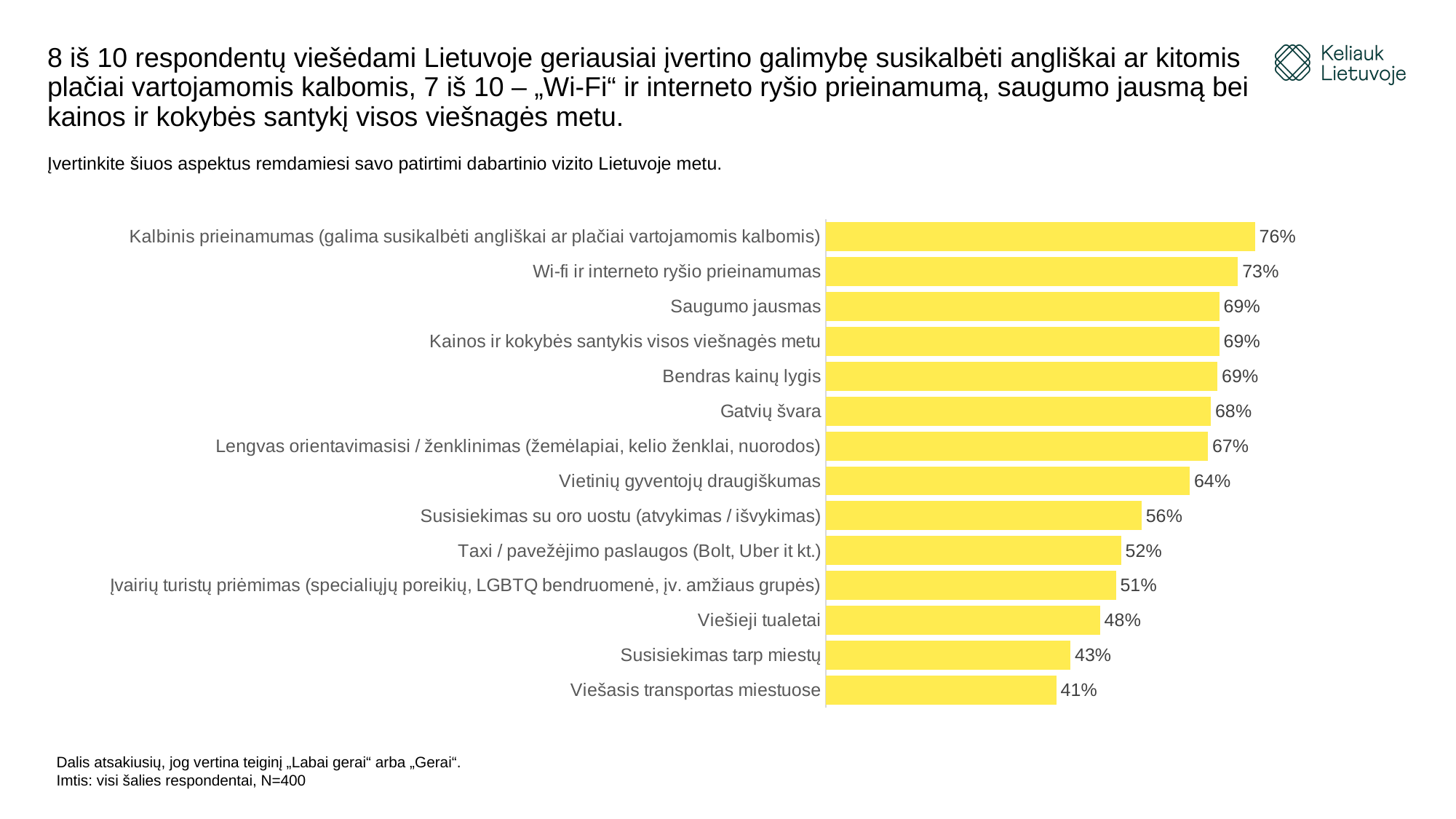
What is the value for "Viešieji tualetai"? 48% What is the value for "Gatvių švara"? 68% What kind of chart is shown on the slide? Bar chart What is the difference between the values for "Kalbinis prieinamumas" and "Viešasis transportas miestuose"? 35% Which category has the lowest value? Viešasis transportas miestuose Which category has the highest value? Kalbinis prieinamumas (galima susikalbėti angliškai ar plačiai vartojamomis kalbomis) How many categories share the value 69%? 3 What colour are the bars in the chart? Yellow How many categories are shown in the chart? 14 What is the value for "Wi-fi ir interneto ryšio prieinamumas"? 73% What is the difference between the values for "Susisiekimas su oro uostu (atvykimas / išvykimas)" and "Taxi / pavežėjimo paslaugos (Bolt, Uber it kt.)"? 4% Which is larger: the value for "Vietinių gyventojų draugiškumas" or the value for "Susisiekimas tarp miestų"? Vietinių gyventojų draugiškumas